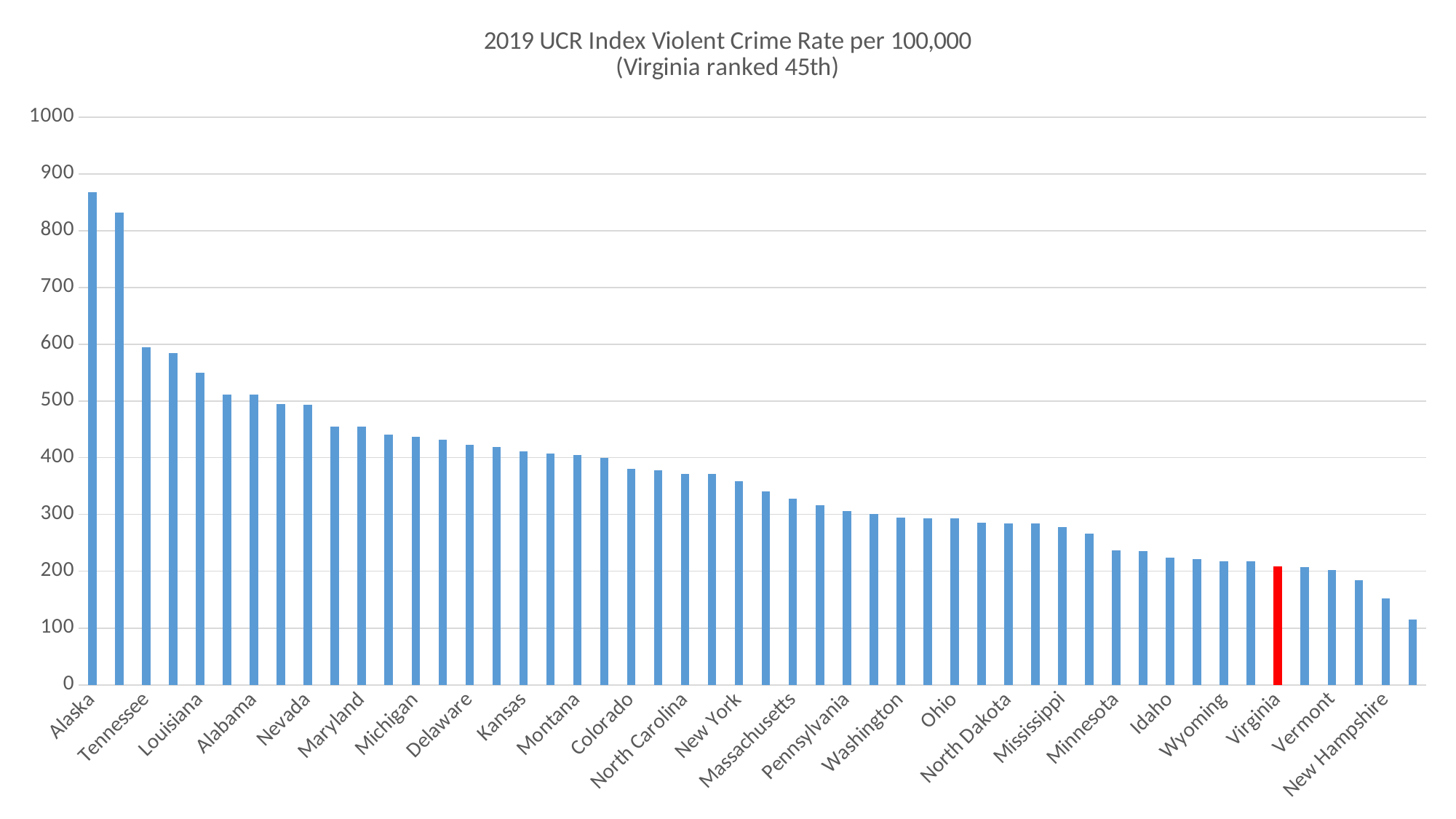
Which has the larger value, Louisiana or Alabama? Louisiana Do the values rise or fall moving from left to right along the x axis? fall Which state has the highest violent crime rate in the chart? Alaska Which state's bar is coloured red? Virginia Is the value for North Carolina greater or less than 400? less Which has the larger value, Virginia or New Hampshire? Virginia What kind of chart is shown on the slide? bar chart Is the value for Louisiana greater or less than 600? less Is the value for Alaska greater or less than 800? greater